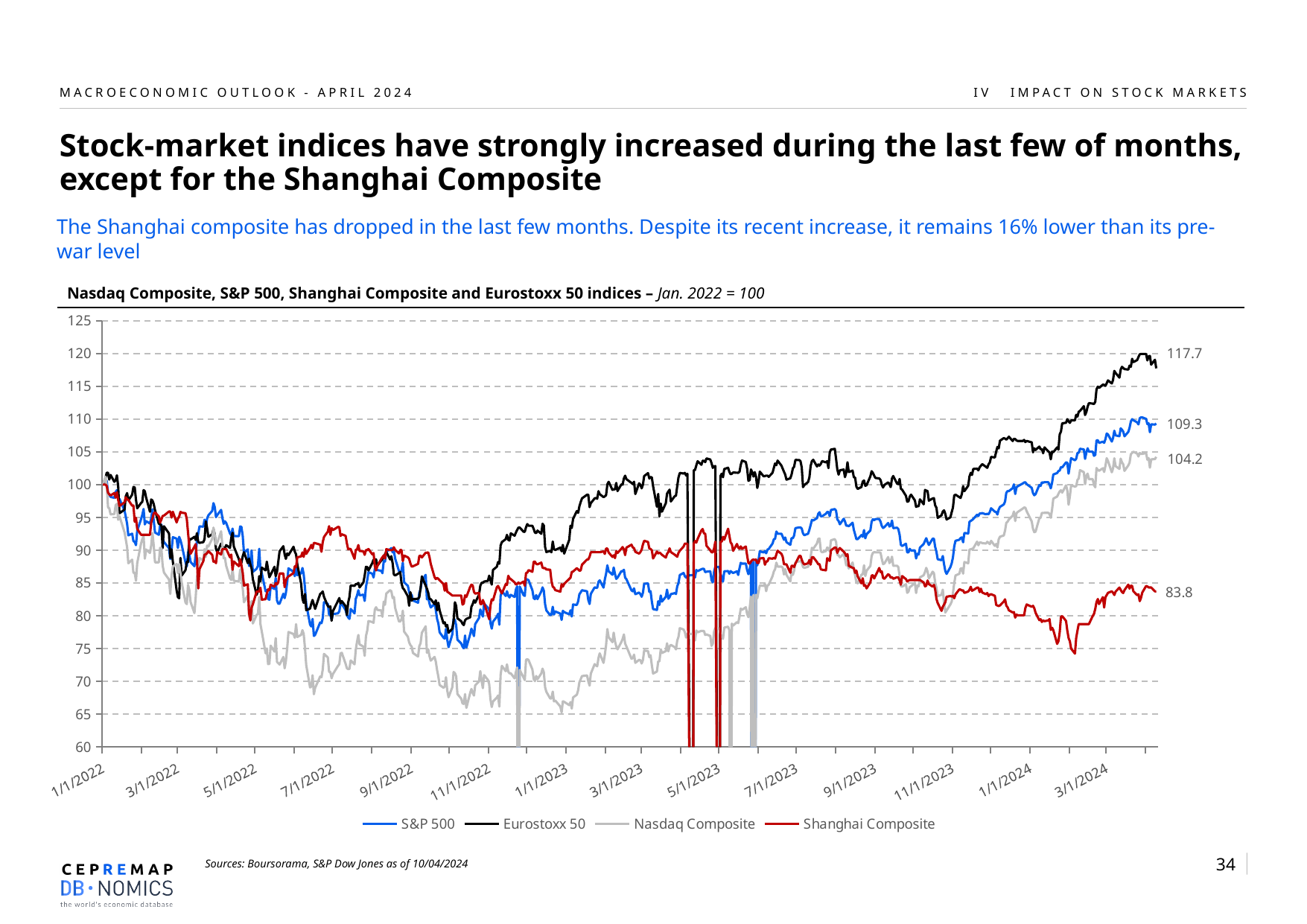
What is the final value shown for the Shanghai Composite index? 83.8 What is the final value shown for the S&P 500 index? 109.3 What is the difference between the final values of the Eurostoxx 50 and the S&P 500? 8.4 Which index has the highest value at the end of the period? Eurostoxx 50 Is the final value of the Shanghai Composite greater or less than 90? less How many series does the legend list? 4 What is the final value shown for the Eurostoxx 50 index? 117.7 Which colour is used for the Shanghai Composite line? red What kind of chart is shown on the slide? line chart What is the final value shown for the Nasdaq Composite index? 104.2 Which index has the lowest value at the end of the period? Shanghai Composite At the end of the period, which is larger: the S&P 500 or the Nasdaq Composite? S&P 500